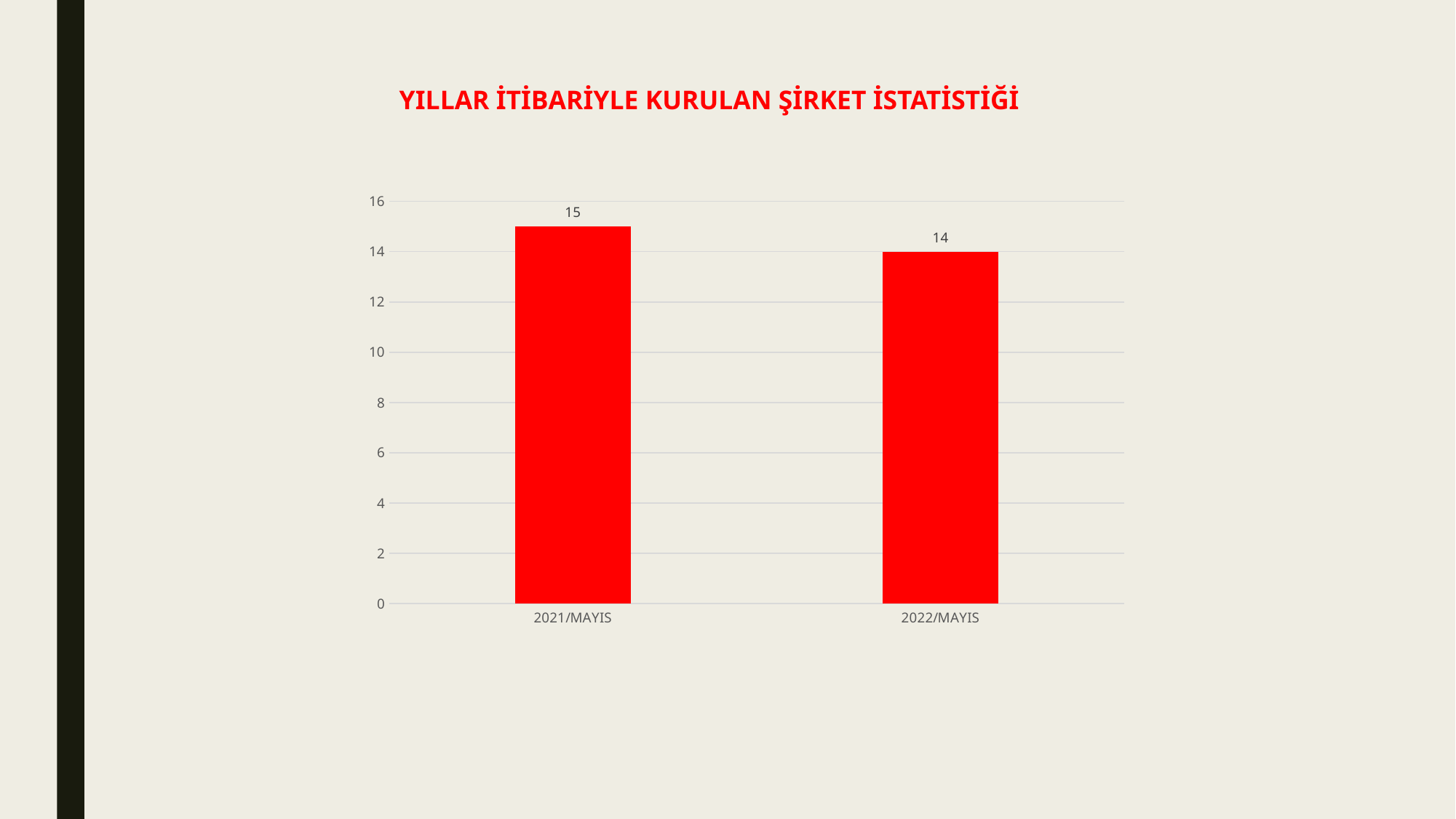
What is the value for 2021/MAYIS? 15 What kind of chart is shown on the slide? bar chart What is the difference between the values for 2021/MAYIS and 2022/MAYIS? 1 Which category has the highest value? 2021/MAYIS Which category has the lowest value? 2022/MAYIS Is the value for 2022/MAYIS greater or less than 10? greater What colour are the bars in the chart? red Which is larger, the value for 2021/MAYIS or the value for 2022/MAYIS? 2021/MAYIS How many categories are shown on the x axis? 2 What is the title of the chart? YILLAR İTİBARİYLE KURULAN ŞİRKET İSTATİSTİĞİ Do the values rise or fall from 2021/MAYIS to 2022/MAYIS? fall What is the value for 2022/MAYIS? 14